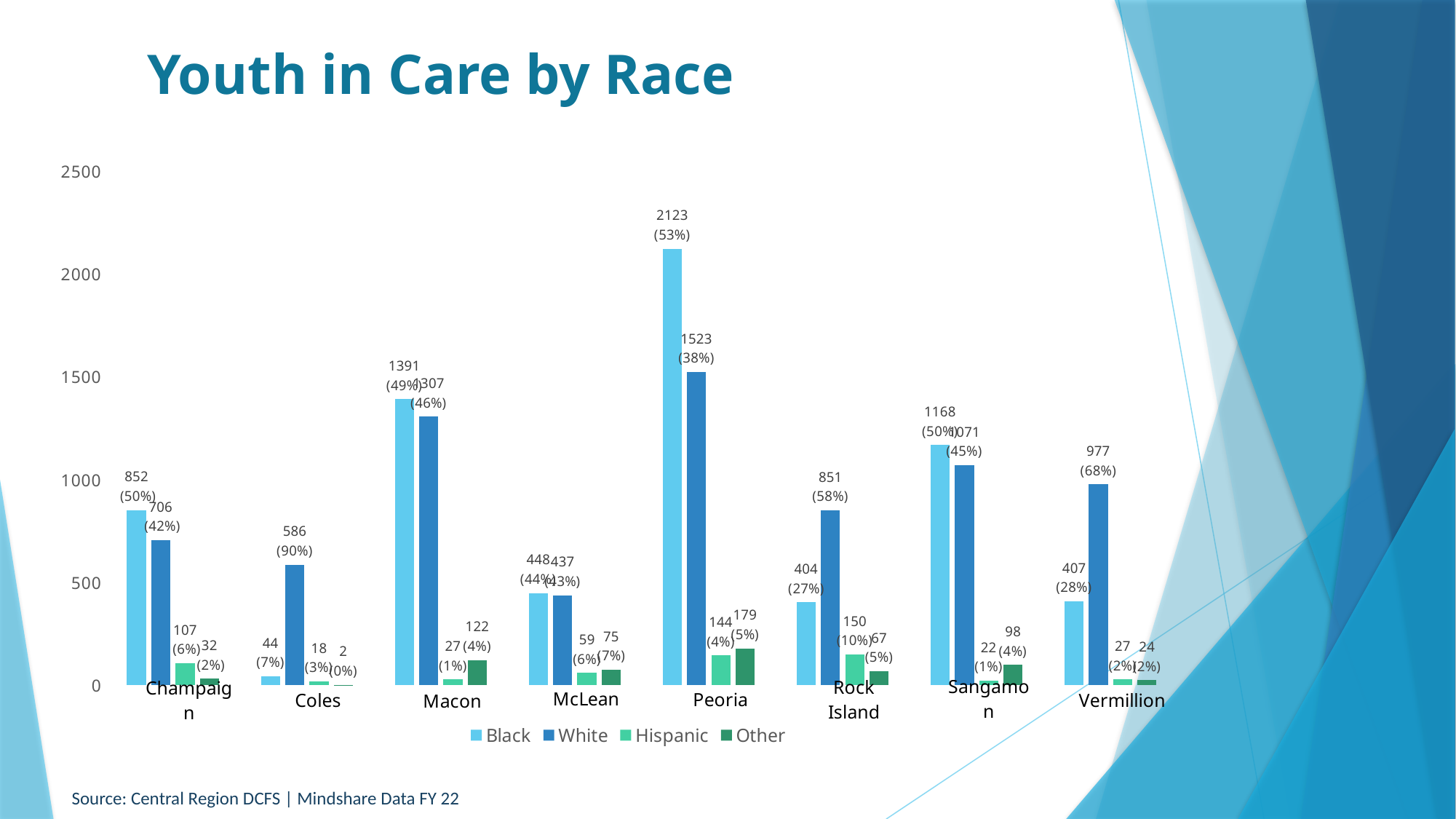
Which county has the highest value for Black? Peoria What kind of chart is shown on the slide? bar chart What is the title of the chart? Youth in Care by Race What is the value for Black in Peoria? 2123 (53%) In Rock Island, which is larger, the Black value or the White value? White How many counties are shown on the x axis? 8 What is the value for White in Coles? 586 (90%) How many series does the legend list? 4 Is the value for White in Vermillion greater or less than 500? greater What is the difference between the Black and White values in Peoria? 600 What is the value for Hispanic in Rock Island? 150 (10%) Which county has the lowest value for Other? Coles